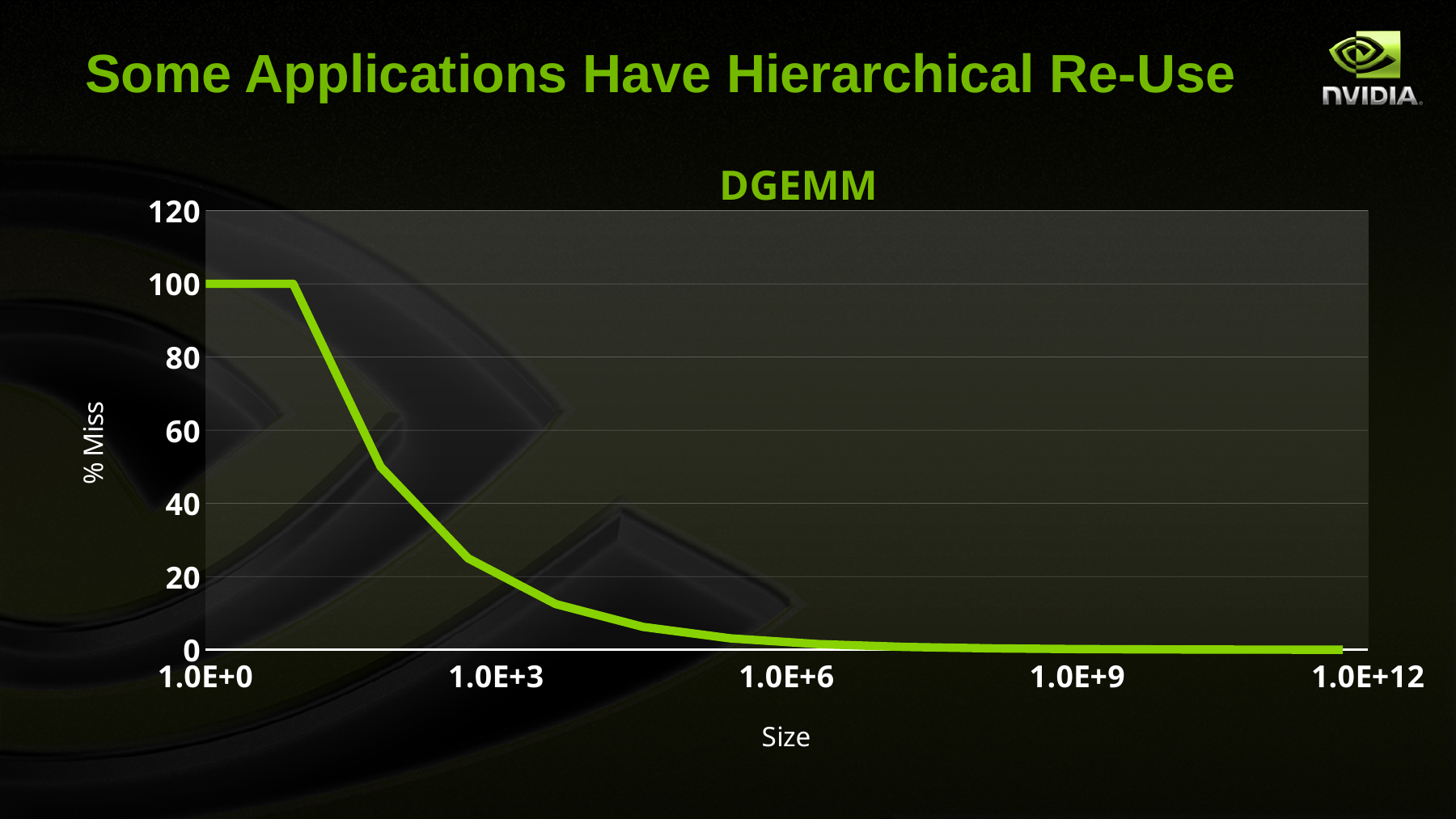
What is the % Miss value at size 1.0E+0? 100 Is the % Miss at size 1.0E+9 greater or less than 20? less What is the label of the y axis? % Miss What kind of chart is shown on the slide? line chart What is the title of the chart? DGEMM Does the % Miss rise or fall as Size increases along the x axis? fall At which labelled size on the x axis is the % Miss highest? 1.0E+0 Is the % Miss at size 1.0E+6 greater or less than 20? less Is the % Miss at size 1.0E+3 greater or less than 40? less How many tick labels are shown on the x axis? 5 Which size has the higher % Miss, 1.0E+0 or 1.0E+6? 1.0E+0